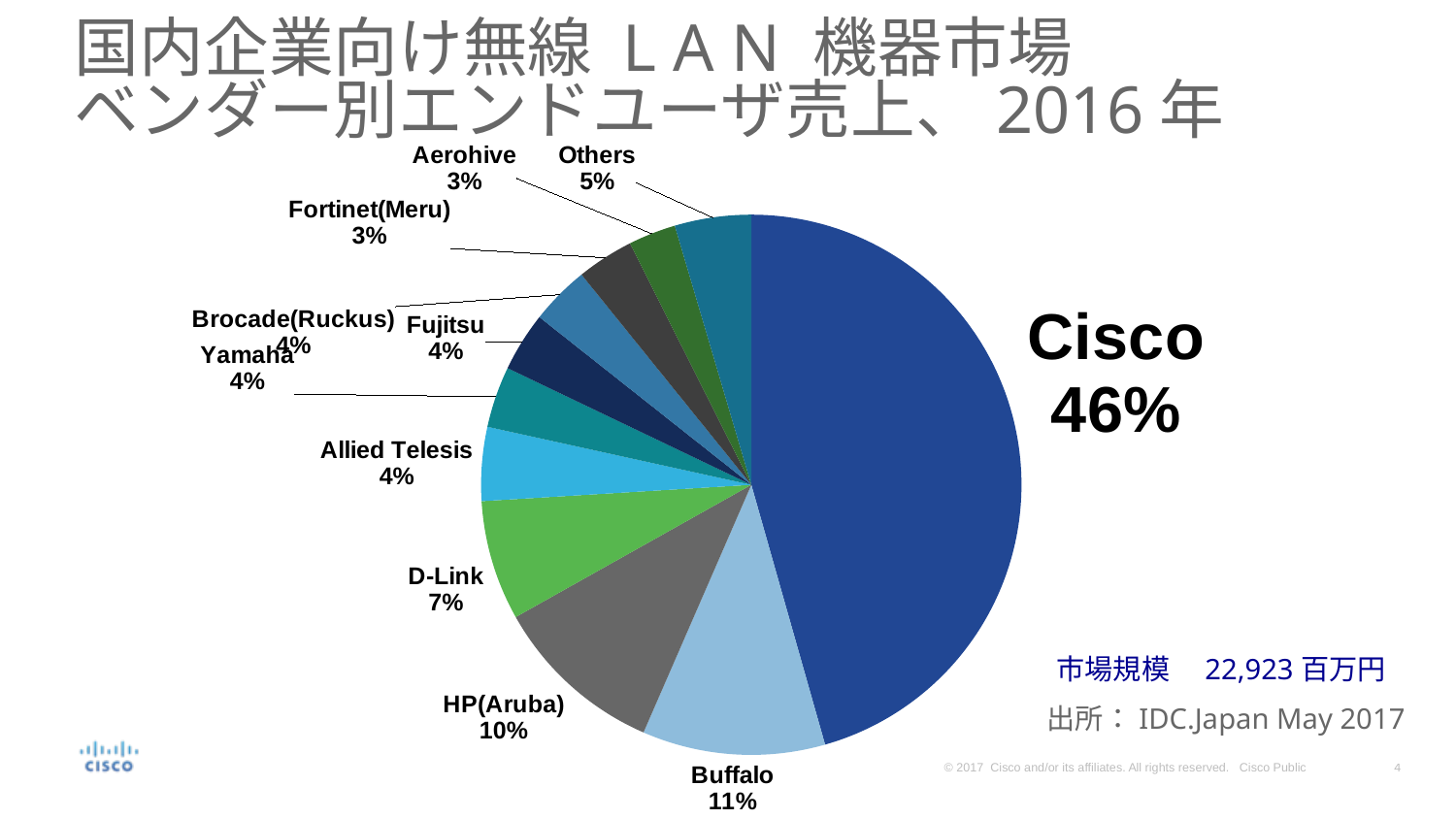
What source is cited for the chart data? IDC.Japan May 2017 What is the value shown for Buffalo? 11% What kind of chart is shown on the slide? pie chart How many slices does the pie chart have? 11 What market size (市場規模) is stated on the slide? 22,923 百万円 What is the difference in percentage points between Cisco's share and Buffalo's share? 35 What is the value shown for Others? 5% Which vendor has the largest slice of the pie? Cisco What is the value shown for HP(Aruba)? 10% What is the value shown for D-Link? 7% Which is larger, the share for Buffalo or the share for HP(Aruba)? Buffalo What share of the market does Cisco hold in the pie chart? 46%